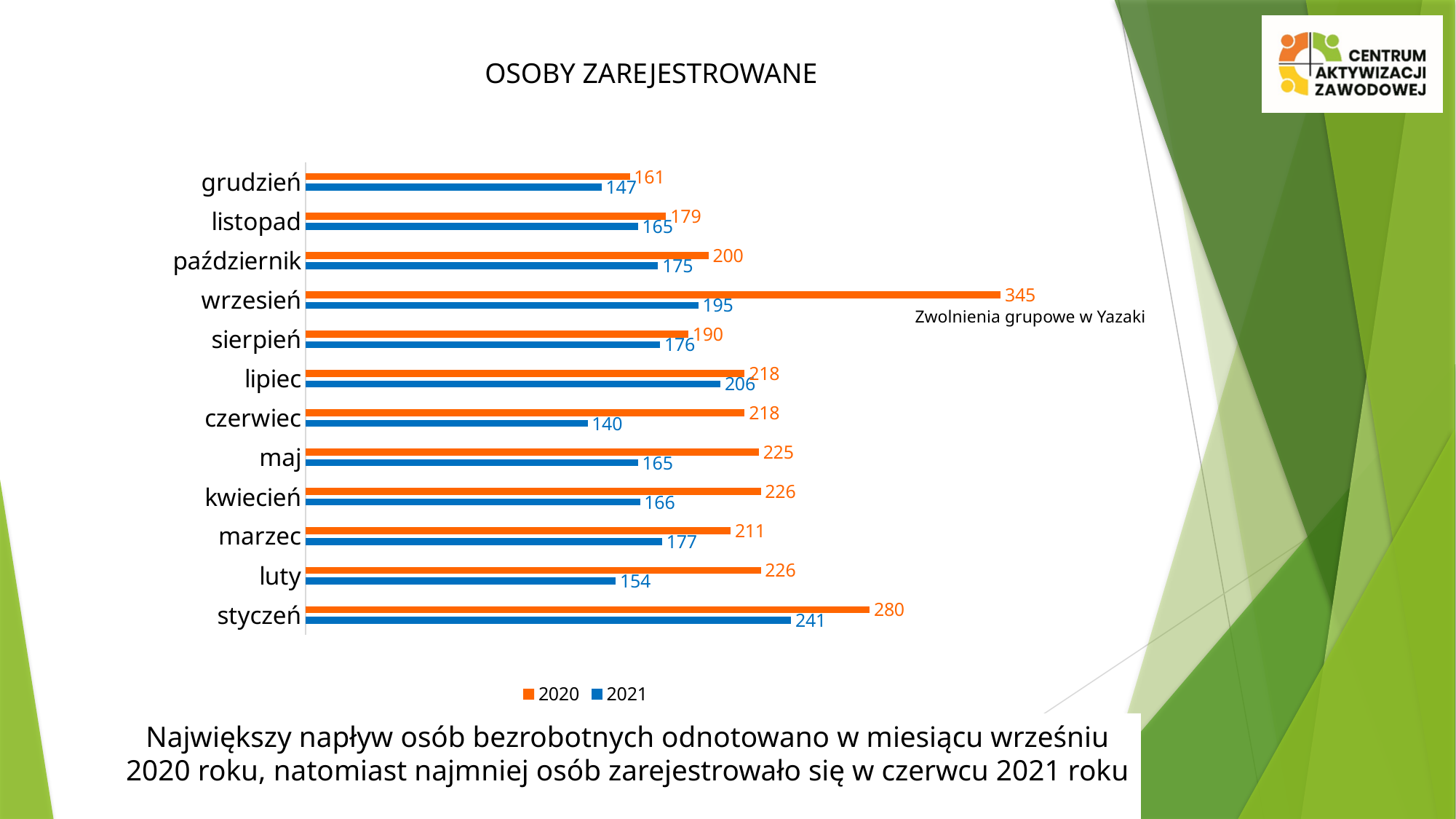
What type of chart is shown on the slide? bar chart Which month has the lowest value in the 2021 series? czerwiec What is the value for styczeń in the 2021 series? 241 Which is larger: the 2021 value for lipiec or the 2021 value for sierpień? lipiec What is the value for wrzesień in the 2020 series? 345 Which month has the highest value in the 2020 series? wrzesień What is the value for czerwiec in the 2021 series? 140 Which month has the lowest value in the 2020 series? grudzień What is the difference between the 2020 and 2021 values for czerwiec? 78 What is the difference between the 2020 and 2021 values for wrzesień? 150 How many series does the legend list? 2 How many months (categories) are shown on the chart? 12